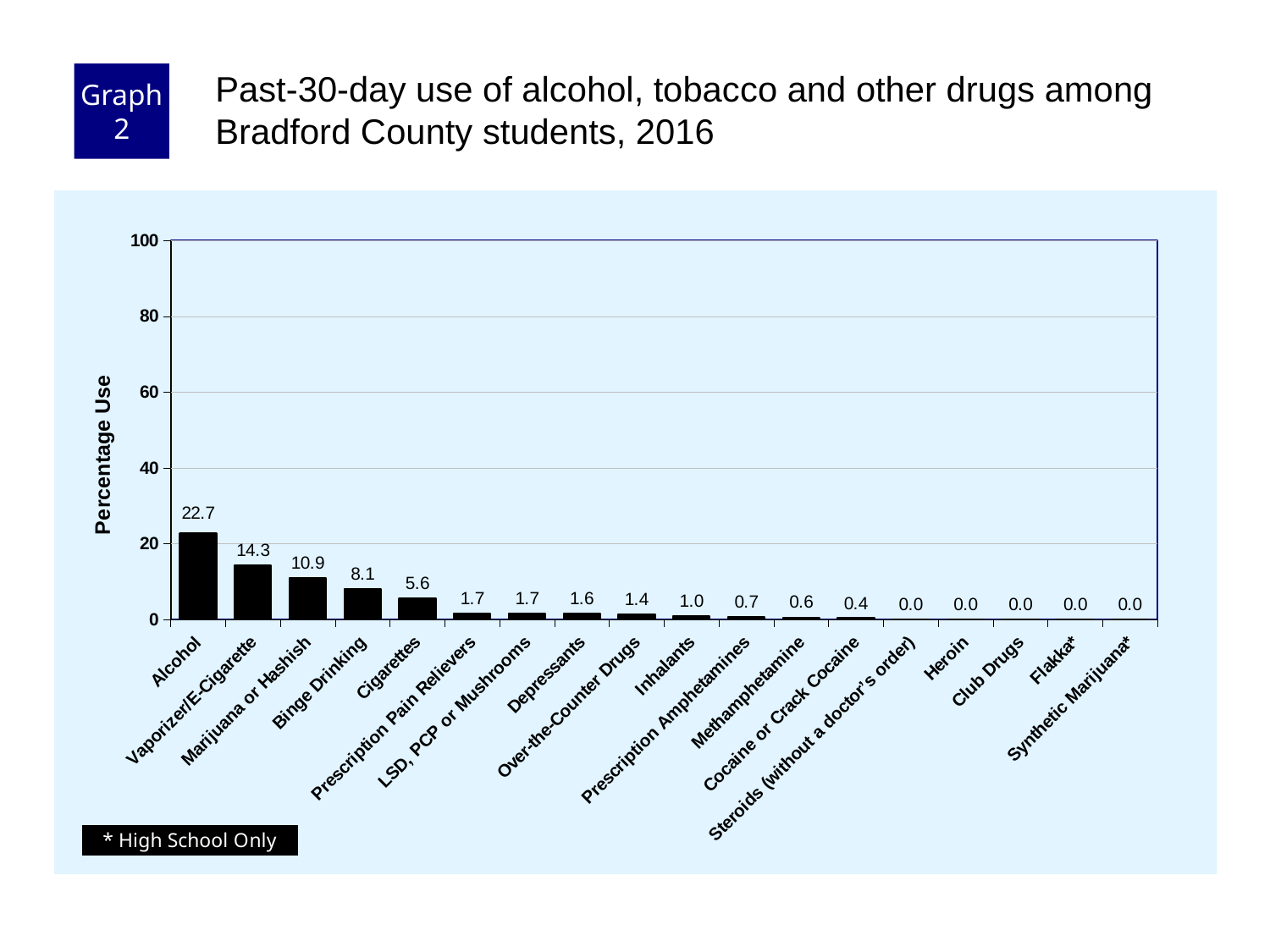
What is the label of the y axis? Percentage Use What is the difference between the values for Alcohol and Marijuana or Hashish? 11.8 Is the value for Alcohol greater or less than 20? greater What kind of chart is shown on the slide? Bar chart Which is larger, the value for Depressants or the value for Methamphetamine? Depressants What is the difference between the values for Cigarettes and Inhalants? 4.6 What is the value shown for Cocaine or Crack Cocaine? 0.4 What is the value shown for Vaporizer/E-Cigarette? 14.3 What is the value shown for Binge Drinking? 8.1 What is the past-30-day use percentage for Alcohol? 22.7 Which category has the highest percentage use? Alcohol How many categories are shown on the x axis? 18